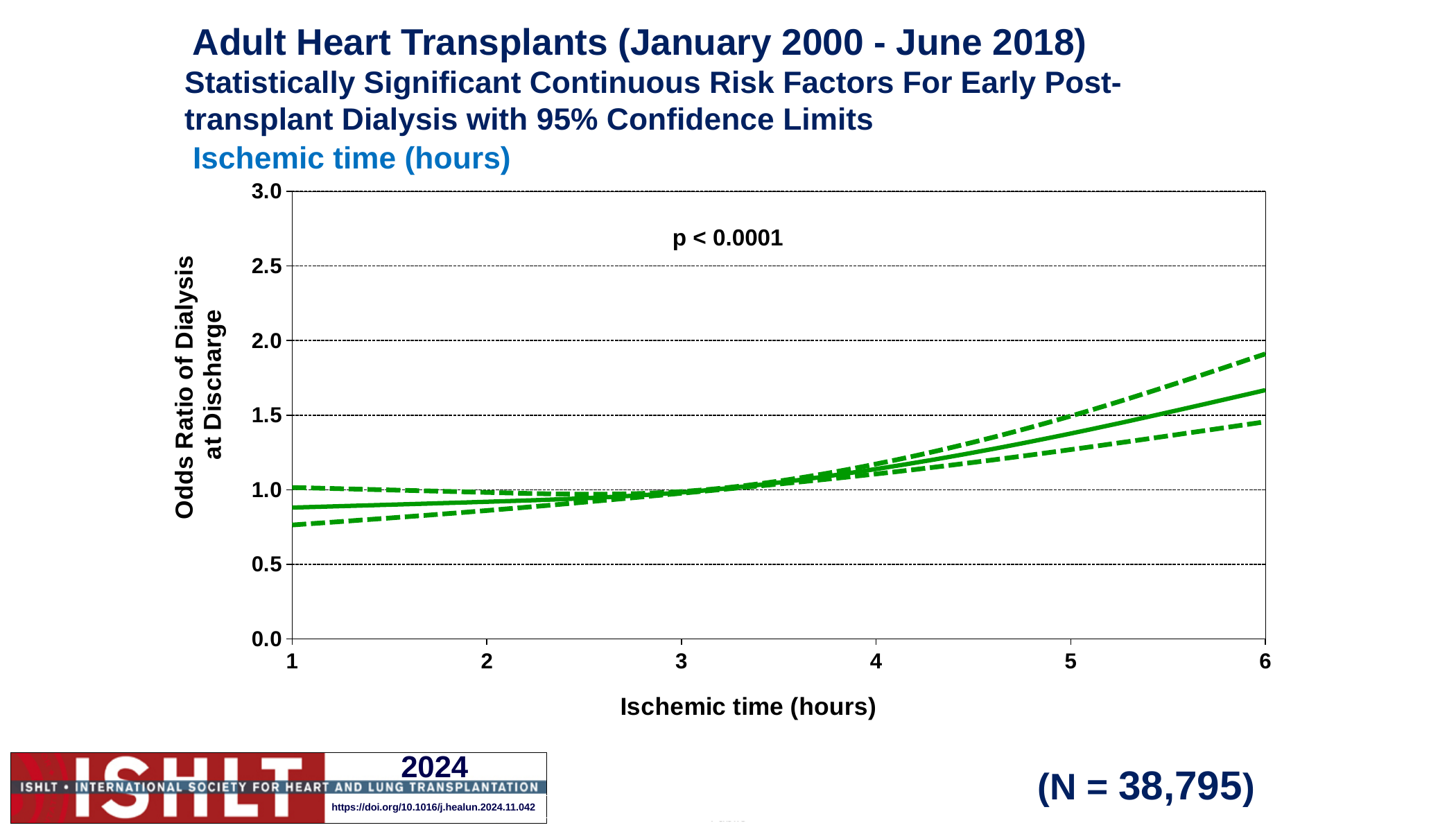
How many lines are plotted on the chart? 3 Does the odds ratio of dialysis at discharge rise or fall as ischemic time increases from 1 to 6 hours? rise Is the odds ratio (solid line) at an ischemic time of 6 hours greater or less than 2.0? less Is the upper 95% confidence limit at an ischemic time of 6 hours greater or less than 1.5? greater Is the lower 95% confidence limit at an ischemic time of 1 hour greater or less than 0.5? greater Which has the larger odds ratio on the solid line: an ischemic time of 1 hour or 6 hours? 6 hours What is the label of the x axis? Ischemic time (hours) What p-value is printed on the chart? p < 0.0001 What kind of chart is shown on the slide? line chart